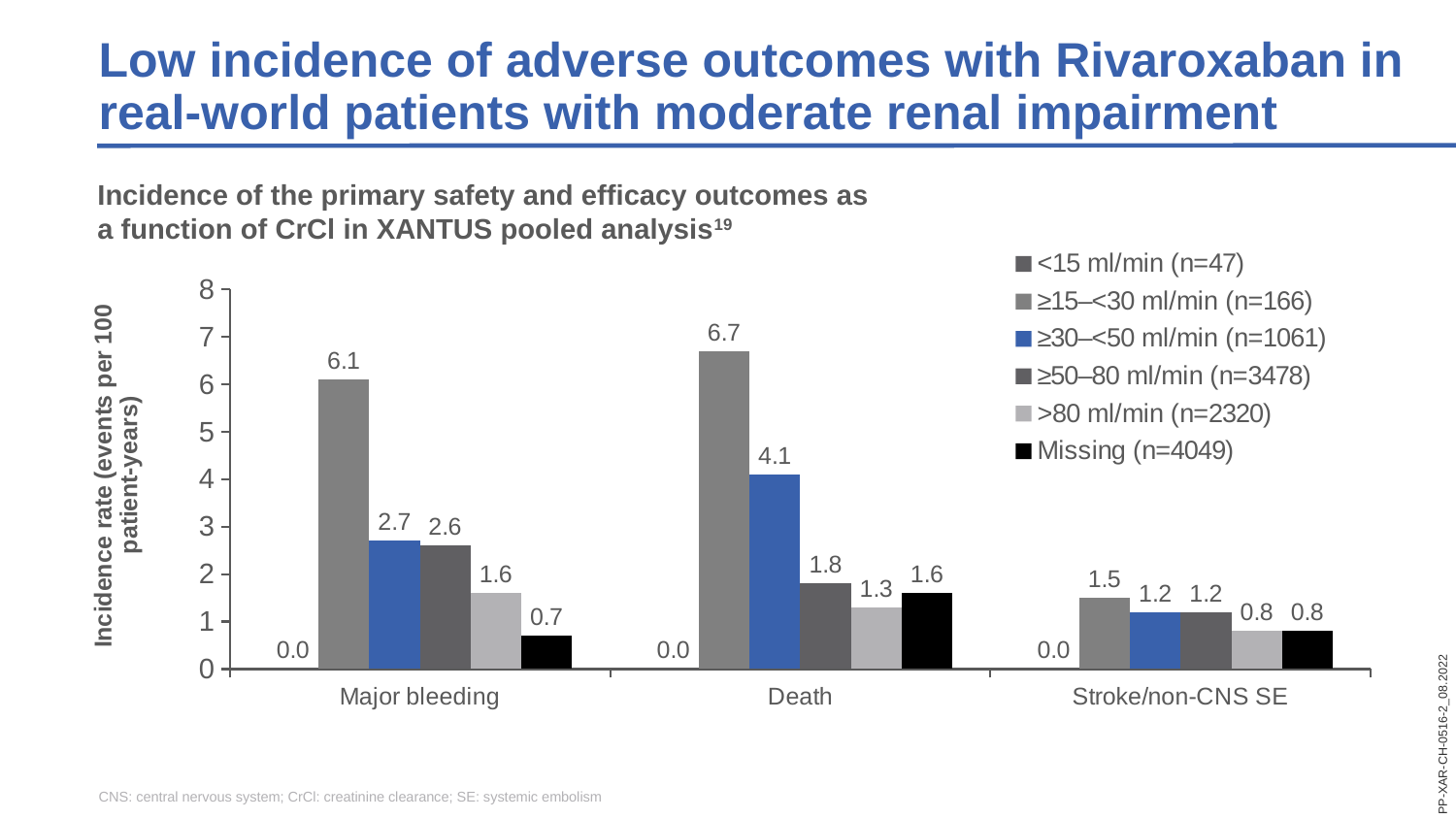
What is the difference between the Death incidence rates for the ≥15–<30 ml/min group and the ≥30–<50 ml/min group? 2.6 What kind of chart is shown on the slide? Bar chart Which CrCl group has the lowest incidence rate for Death? <15 ml/min (n=47) What is the incidence rate for Stroke/non-CNS SE in the Missing (n=4049) group? 0.8 Which outcome has the highest incidence rate in the ≥30–<50 ml/min (n=1061) group? Death How many CrCl groups does the legend list? 6 What is the incidence rate for Major bleeding in the >80 ml/min (n=2320) group? 1.6 What is the incidence rate for Major bleeding in the ≥30–<50 ml/min (n=1061) group? 2.7 What is the incidence rate for Death in the ≥15–<30 ml/min (n=166) group? 6.7 Which is larger: the Major bleeding rate for the ≥50–80 ml/min group or the Death rate for the ≥50–80 ml/min group? Major bleeding rate for the ≥50–80 ml/min group How many outcome categories are shown on the x axis? 3 What is the label of the y axis? Incidence rate (events per 100 patient-years)